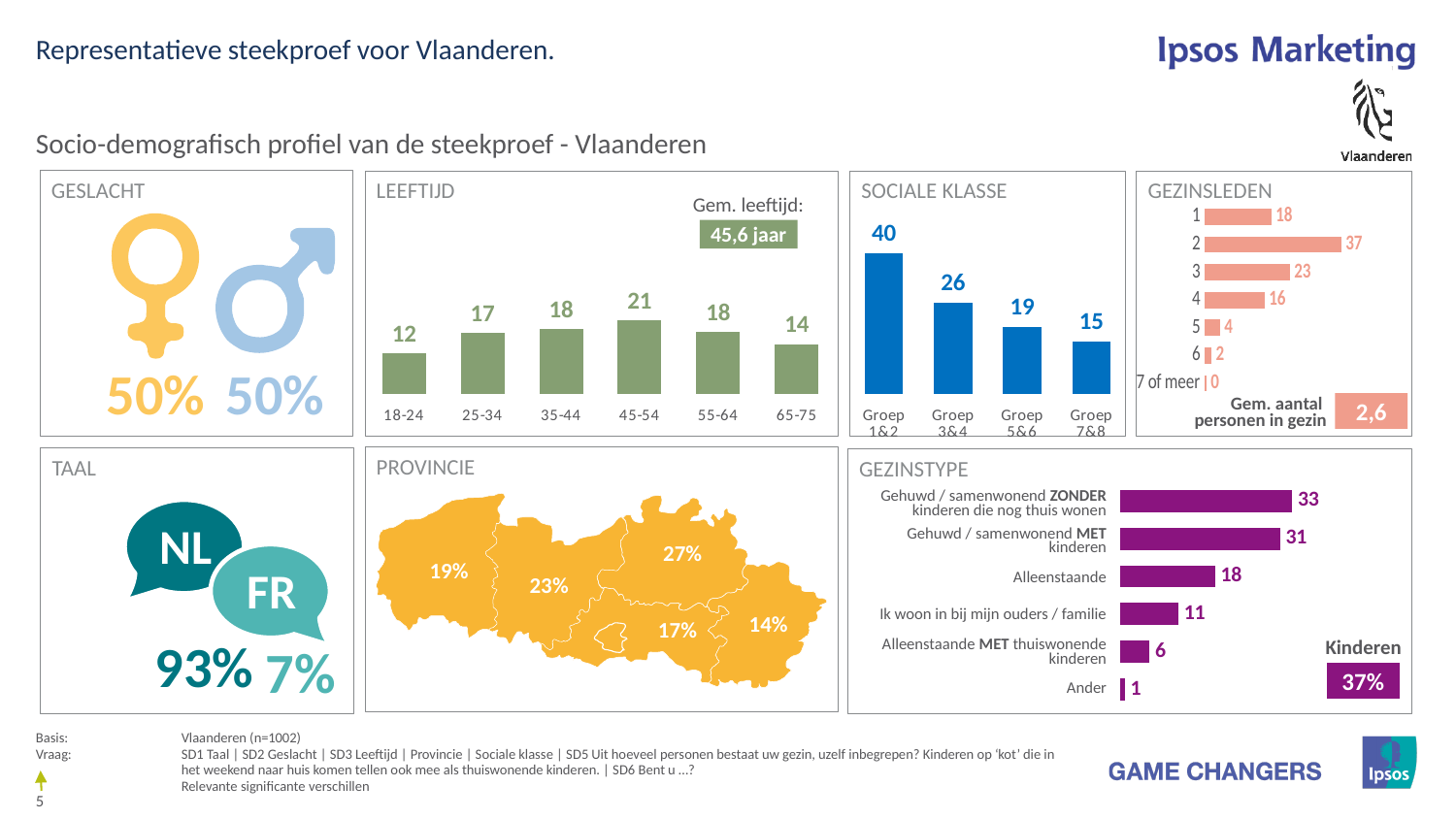
In the SOCIALE KLASSE chart, do the values rise or fall from Groep 1&2 to Groep 7&8? fall In the GEZINSTYPE chart, what is the value for Alleenstaande? 18 In the GEZINSLEDEN chart, what is the average number of persons per household (Gem. aantal personen in gezin)? 2,6 In the GEZINSLEDEN chart, what is the value for 3 gezinsleden? 23 In the SOCIALE KLASSE chart, what is the difference between Groep 1&2 and Groep 3&4? 14 In the GEZINSLEDEN chart, which category has the highest value? 2 In the LEEFTIJD chart, which age group has the lowest value? 18-24 What kind of chart is the GEZINSTYPE chart? bar chart In the LEEFTIJD chart, what is the value for the 45-54 age group? 21 In the LEEFTIJD chart, how many age groups are shown? 6 In the GEZINSTYPE chart, which is larger: Gehuwd / samenwonend ZONDER kinderen die nog thuis wonen or Gehuwd / samenwonend MET kinderen? Gehuwd / samenwonend ZONDER kinderen die nog thuis wonen In the SOCIALE KLASSE chart, what is the value for Groep 1&2? 40